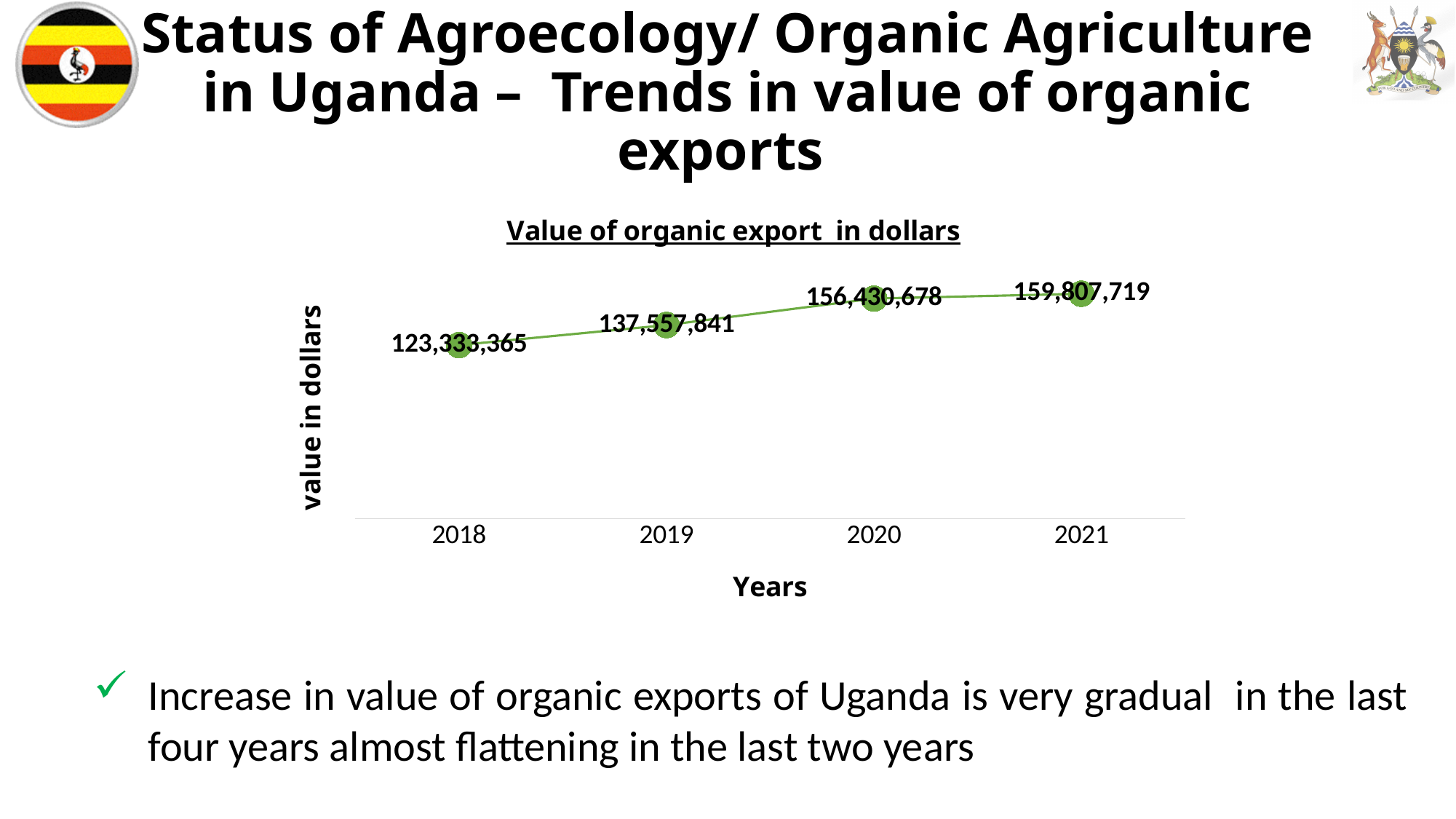
Which year has the highest value of organic exports? 2021 What is the difference between the value of organic exports in 2021 and in 2020? 3,377,041 What is the value of organic exports in 2018? 123,333,365 What is the value of organic exports in 2021? 159,807,719 Which year has the lowest value of organic exports? 2018 What is the difference between the value of organic exports in 2019 and in 2018? 14,224,476 What is the value of organic exports in 2019? 137,557,841 Which year has a larger value of organic exports, 2019 or 2020? 2020 What kind of chart is shown on the slide? Line chart How many years are plotted on the chart? 4 What is the value of organic exports in 2020? 156,430,678 Do the values of organic exports rise or fall from 2018 to 2021? Rise